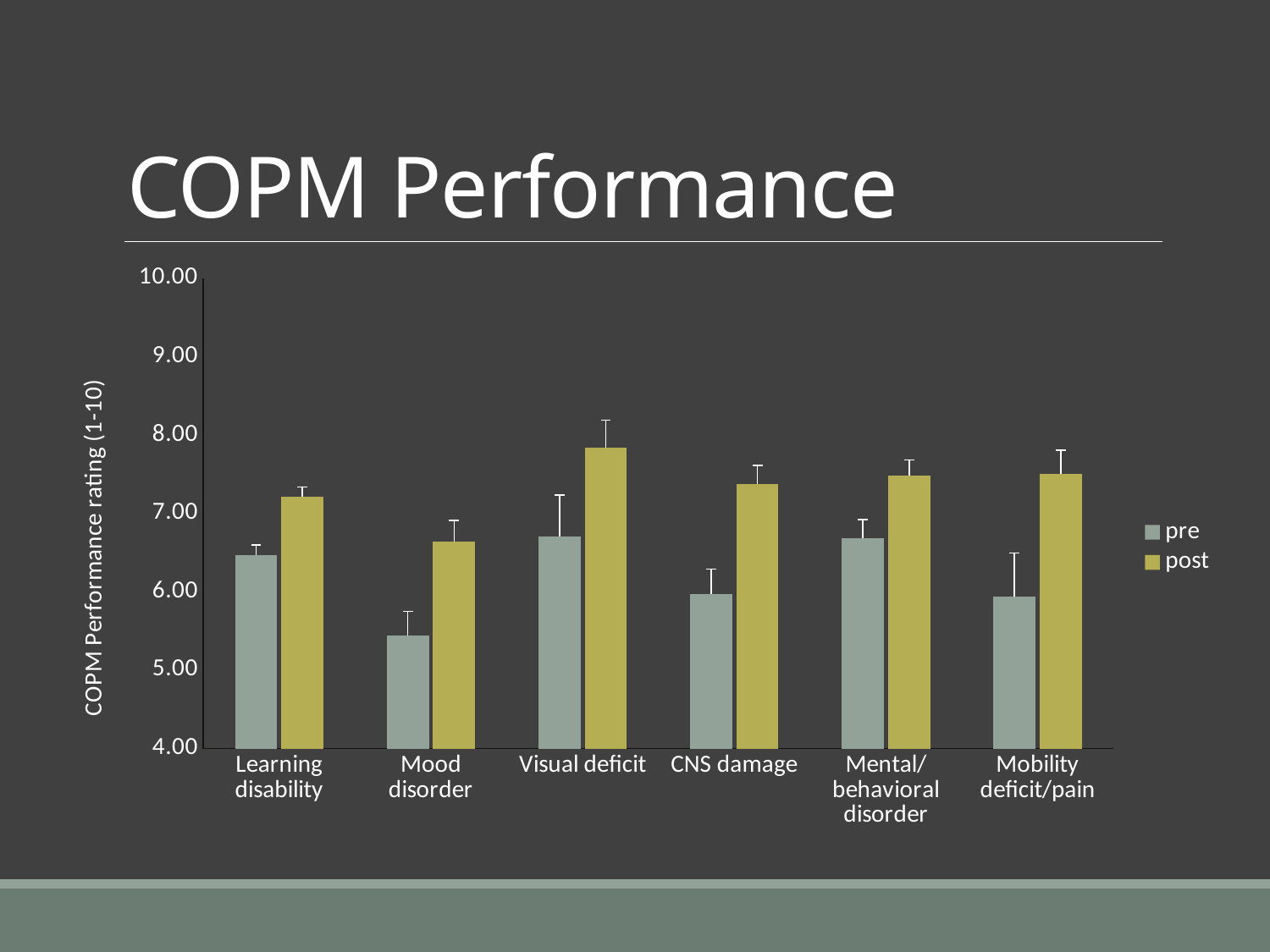
Which is larger, the post value for Visual deficit or the post value for Learning disability? Visual deficit Is the post value for Mood disorder greater or less than 7.00? less How many series does the legend list? 2 Is the post value for Visual deficit greater or less than 7.00? greater How many categories are shown on the x axis? 6 Is the pre value for Mood disorder greater or less than 6.00? less What is the title of the y axis? COPM Performance rating (1-10) Which category has the highest post value? Visual deficit Which category has the lowest pre value? Mood disorder For Mood disorder, which is larger, the pre value or the post value? post What kind of chart is shown on the slide? bar chart